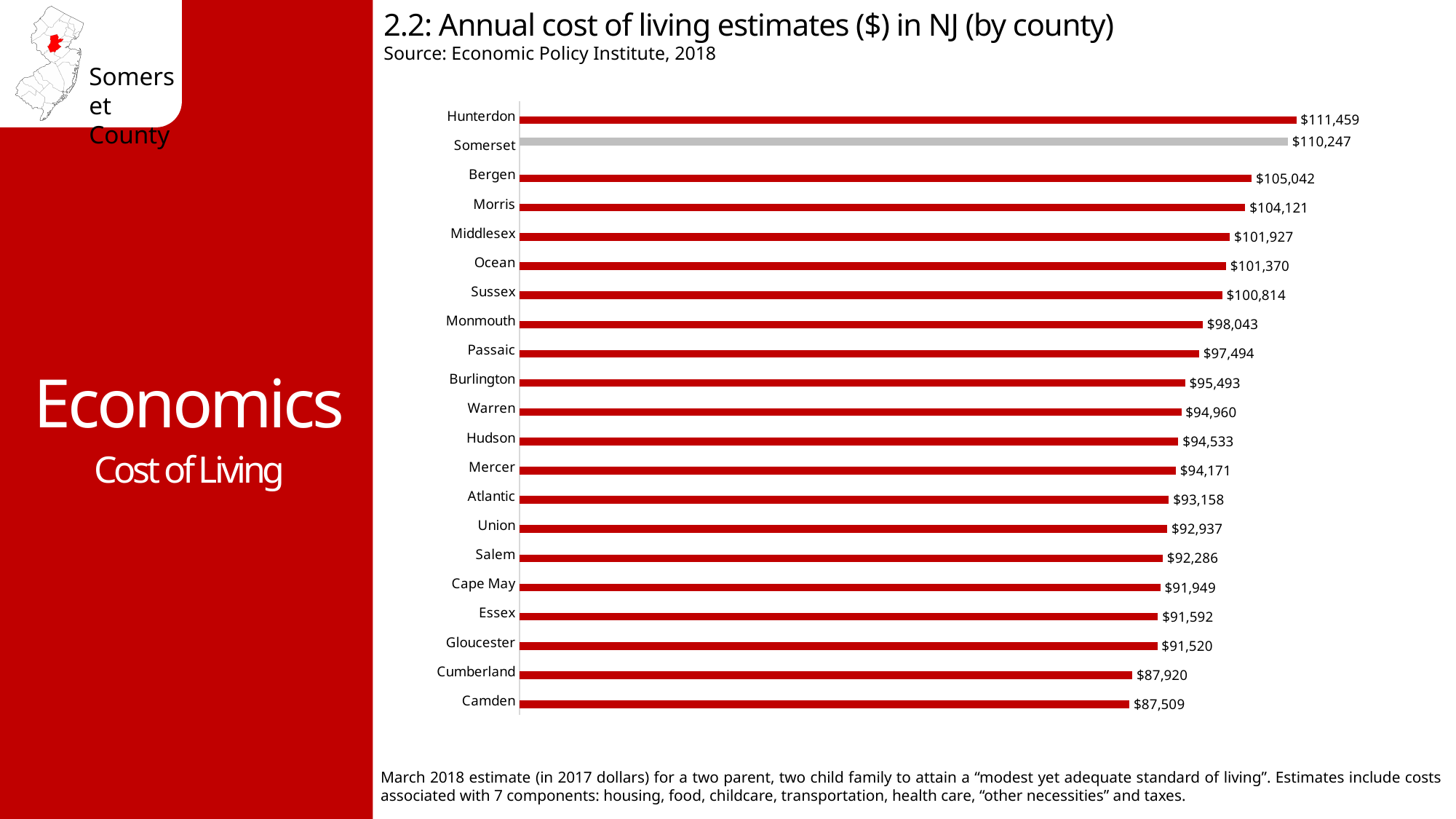
Which county has a higher cost of living estimate, Bergen or Morris? Bergen What is the annual cost of living estimate for Cape May County? $91,949 What is the difference between the cost of living estimates for Cumberland and Camden counties? $411 Which county has the highest annual cost of living estimate? Hunterdon Which county has the lowest annual cost of living estimate? Camden What is the difference between the cost of living estimates for Hunterdon and Somerset counties? $1,212 What is the annual cost of living estimate for Somerset County? $110,247 What is the annual cost of living estimate for Monmouth County? $98,043 What type of chart is used to show the cost of living estimates? Bar chart Which county has a higher cost of living estimate, Passaic or Burlington? Passaic Which county's bar is shown in a different colour (grey) from the others? Somerset How many counties are shown in the chart? 21